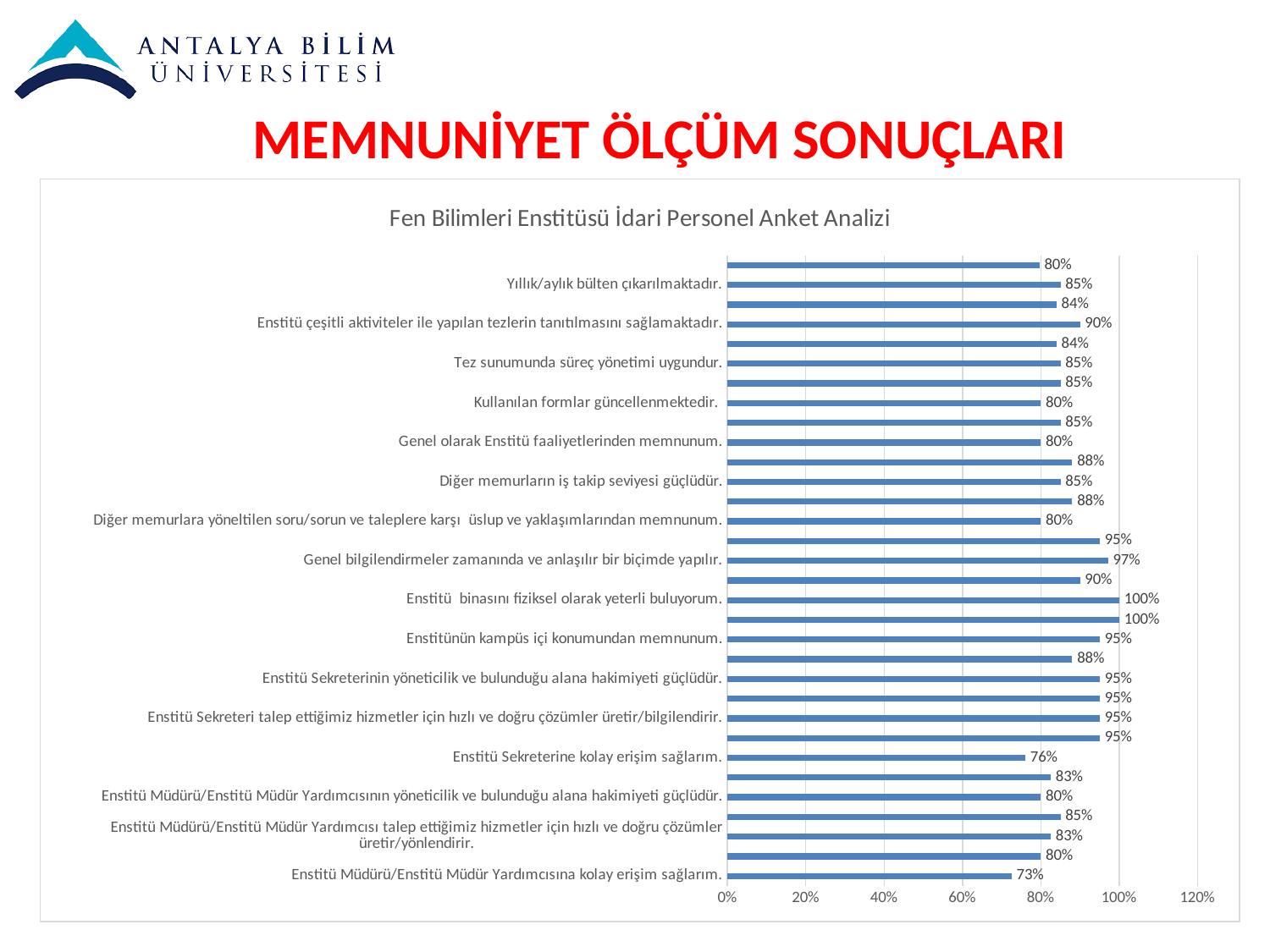
What is the highest value shown in the chart? 100% What is the value for "Enstitü çeşitli aktiviteler ile yapılan tezlerin tanıtılmasını sağlamaktadır."? 90% Which labeled item has the lowest value in the chart? Enstitü Müdürü/Enstitü Müdür Yardımcısına kolay erişim sağlarım. Is the value for "Enstitü Sekreterine kolay erişim sağlarım." greater or less than 80%? less What is the difference between the values for "Genel bilgilendirmeler zamanında ve anlaşılır bir biçimde yapılır." and "Enstitü Sekreterine kolay erişim sağlarım."? 21 percentage points What is the value for "Enstitü binasını fiziksel olarak yeterli buluyorum."? 100% What is the title of the chart? Fen Bilimleri Enstitüsü İdari Personel Anket Analizi What is the value for "Enstitü Müdürü/Enstitü Müdür Yardımcısına kolay erişim sağlarım."? 73% Which is larger: the value for "Enstitü Sekreterine kolay erişim sağlarım." or for "Enstitü Müdürü/Enstitü Müdür Yardımcısına kolay erişim sağlarım."? Enstitü Sekreterine kolay erişim sağlarım. What is the value for "Genel bilgilendirmeler zamanında ve anlaşılır bir biçimde yapılır."? 97% What kind of chart is shown on the slide? bar chart What is the value for "Enstitü Sekreterine kolay erişim sağlarım."? 76%